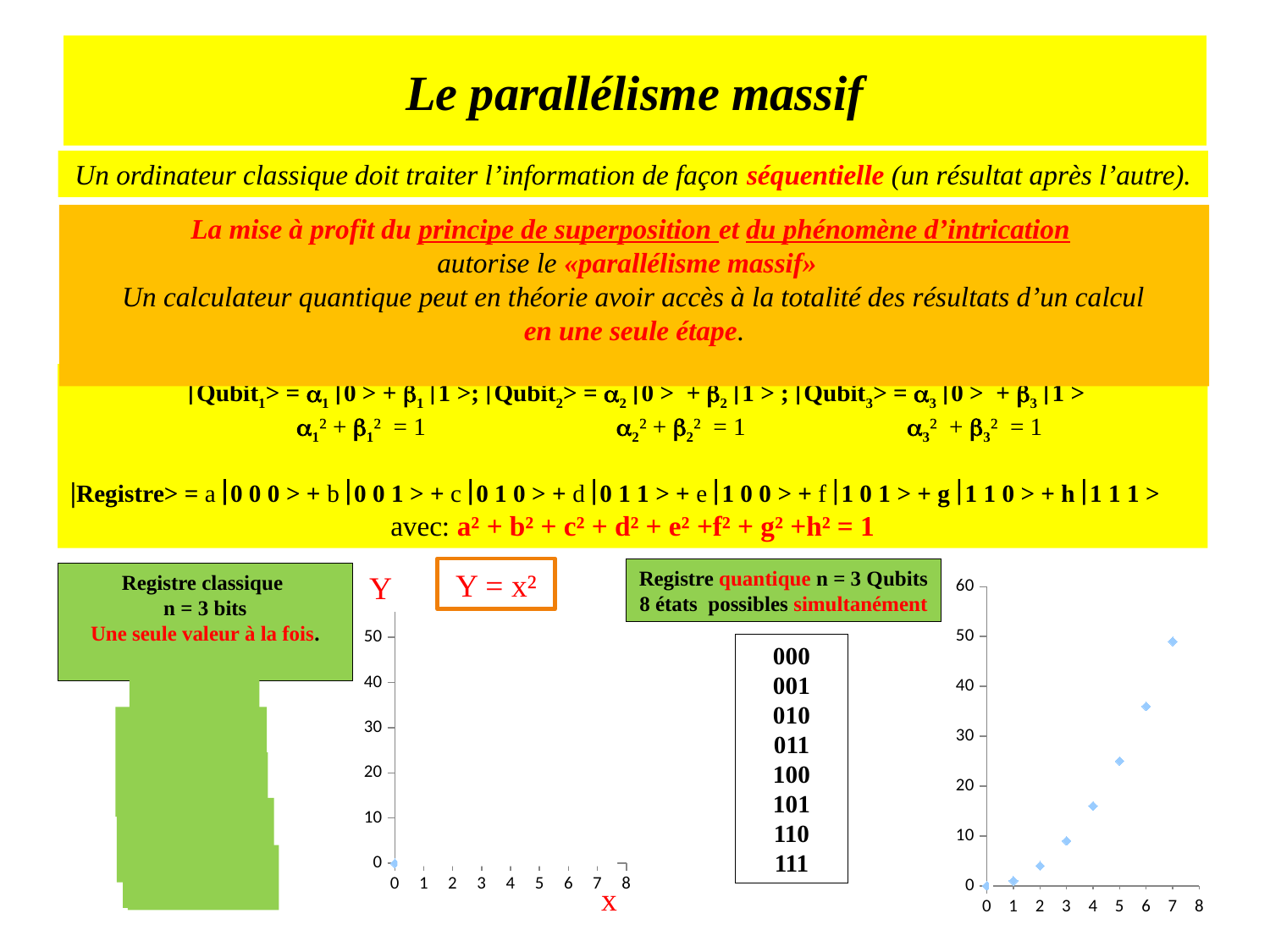
In the chart on the right side of the slide, is the value at x = 6 greater or less than 40? less What equation is shown in the orange box above the left chart? Y = x² In the chart on the right side of the slide, at which x value is the plotted point lowest? 0 In the chart on the right side of the slide, at which x value is the plotted point highest? 7 What kind of chart is the chart on the right side of the slide? scatter chart In the chart on the right side of the slide, how many data points are plotted? 8 In the chart on the right side of the slide, do the values rise or fall as x increases from 0 to 7? rise In the chart on the right side of the slide, is the value at x = 4 greater or less than 20? less In the chart on the right side of the slide, is the value at x = 6 greater or less than 30? greater In the chart on the right side of the slide, which point is higher, the one at x = 3 or the one at x = 5? x = 5 What is the highest tick value shown on the vertical axis of the chart on the right side of the slide? 60